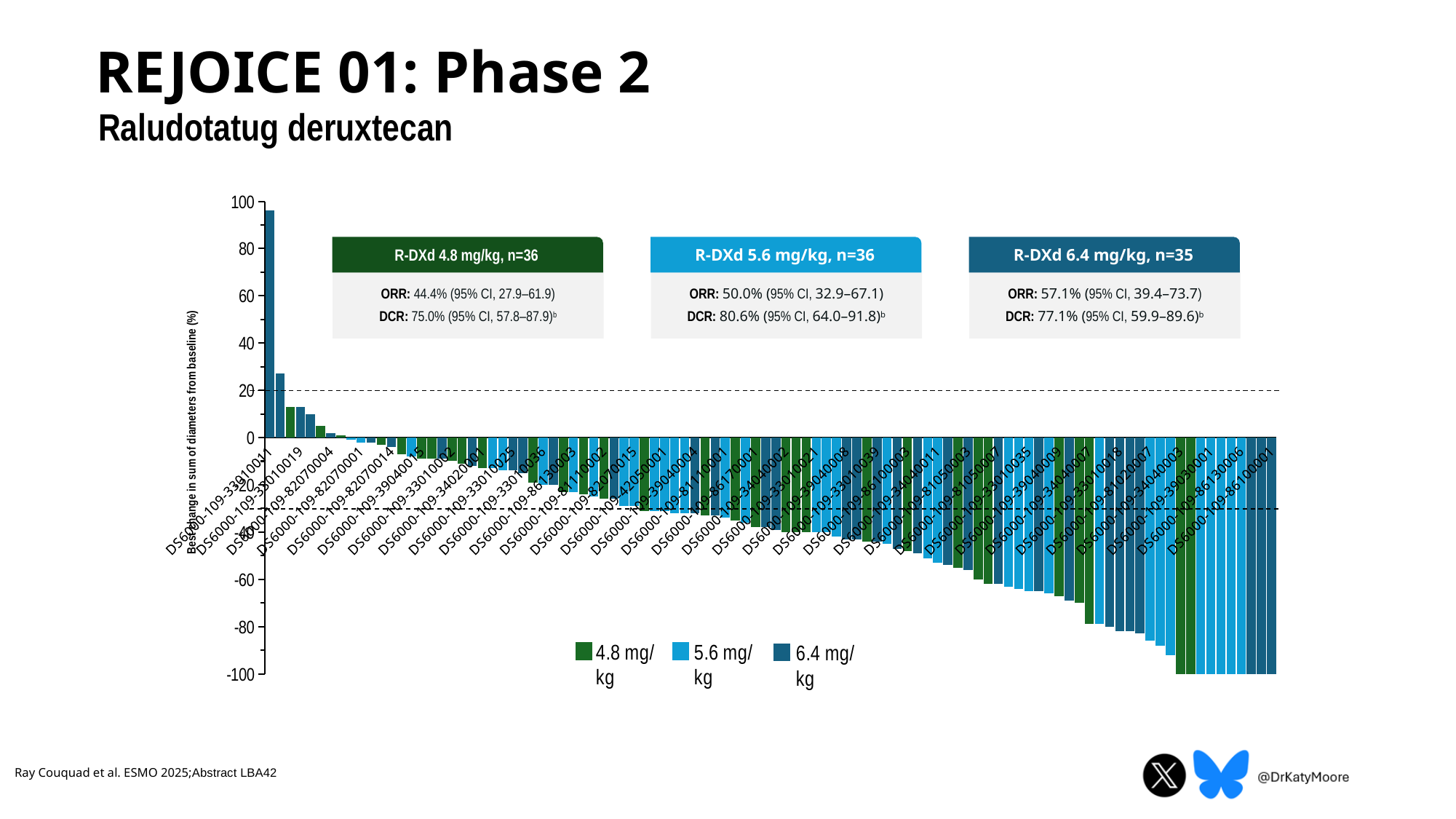
Which bar has the highest value, the leftmost bar or the rightmost bar? The leftmost bar Do the bar values rise or fall moving from left to right along the x axis? Fall Is the value for the second bar from the left greater or less than 20? greater How many series does the chart legend list? 3 What is the lowest value shown on the y axis? -100 Is the value for the leftmost bar greater or less than 80? greater What are the three series listed in the chart legend? 4.8 mg/kg, 5.6 mg/kg, 6.4 mg/kg Is the value for the rightmost bar greater or less than -80? less What does the y axis of the chart measure? Best change in sum of diameters from baseline (%) What kind of chart is shown on the slide? Bar chart What is the highest value shown on the y axis? 100